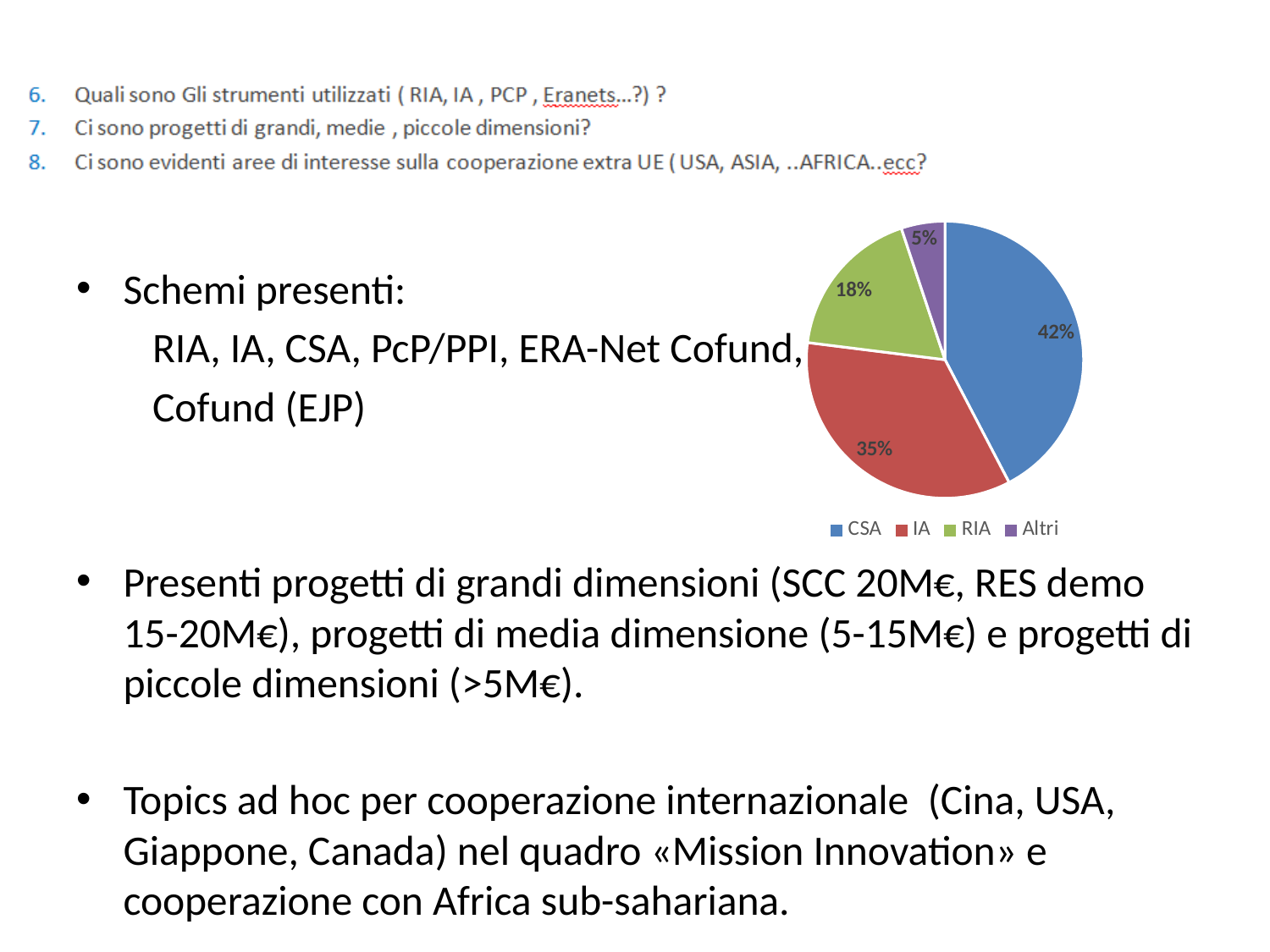
What share of the pie does IA have? 35% What is the difference between the IA and RIA shares? 17% Which category has the smallest slice of the pie? Altri What is the difference between the CSA and IA shares? 7% Which category has the largest slice of the pie? CSA What kind of chart is shown on the slide? pie chart Which is larger, the RIA slice or the Altri slice? RIA How many categories does the pie chart show? 4 What share of the pie does Altri have? 5% What share of the pie does RIA have? 18% Which colour represents IA in the pie chart? red